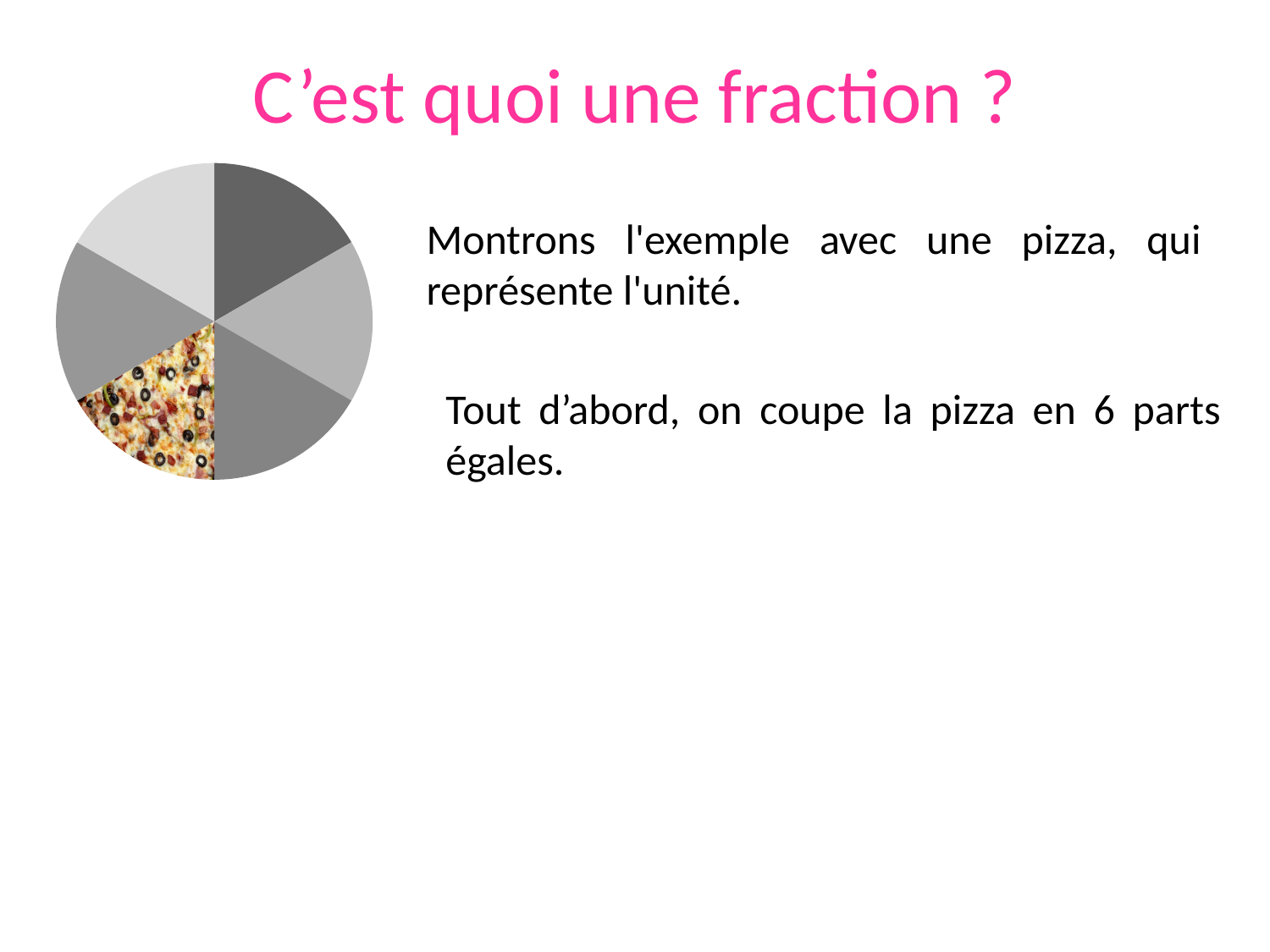
How many slices does the pie chart have? 6 How many slices of the pie chart are filled with the pizza image? 1 What fraction of the pie does the slice filled with the pizza image represent? 1/6 What kind of chart is shown on the slide? pie chart Are the slices of the pie chart equal in size? yes